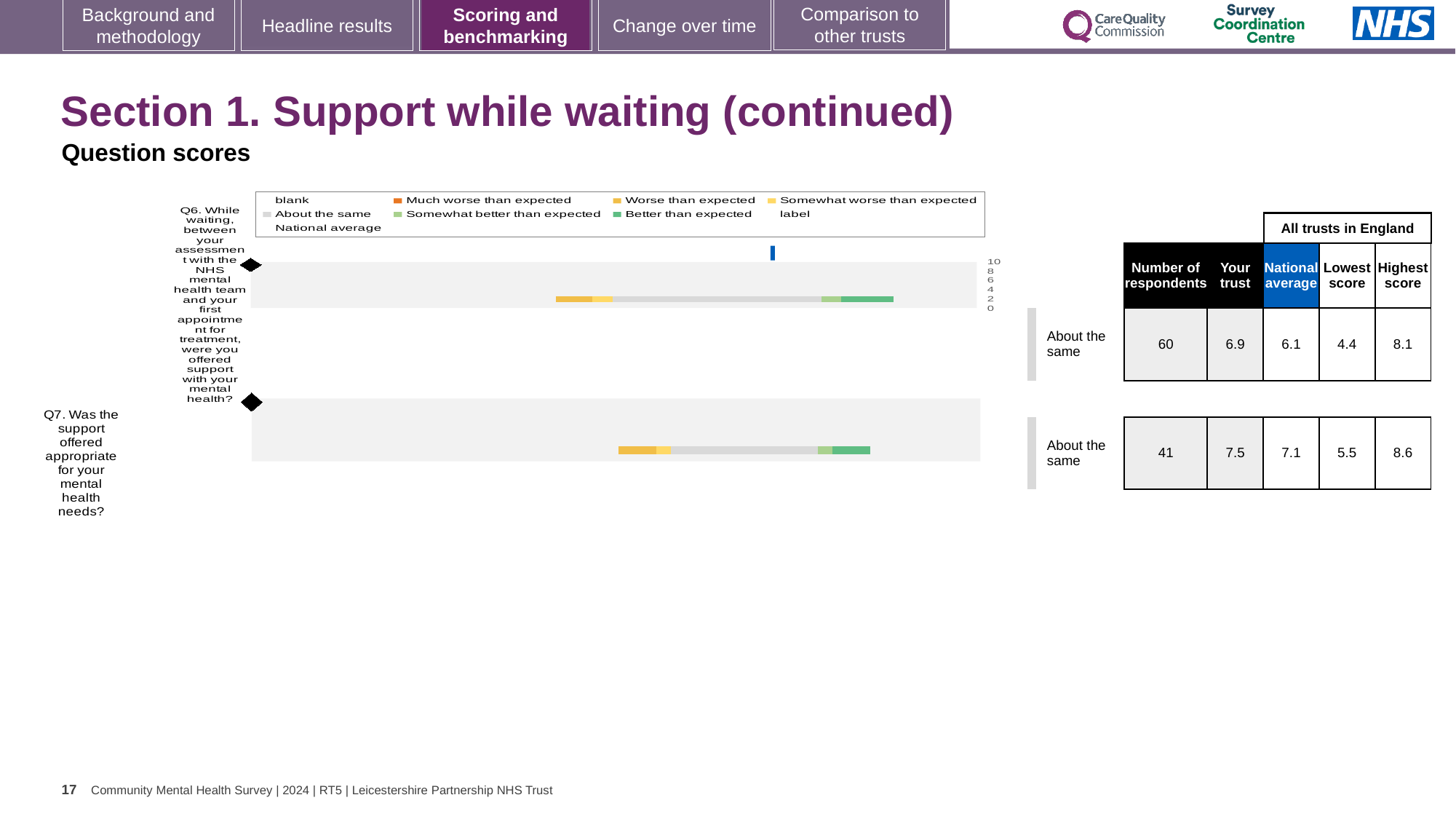
How many questions (categories) are plotted on the chart? 2 What is the 'Your trust' score for Q6 (support while waiting between assessment and first appointment)? 6.9 Which question has the lower number of respondents? Q7 What is the lowest score among all trusts in England for Q6? 4.4 What benchmark rating is shown for both Q6 and Q7? About the same What is the national average score for Q7 (was the support offered appropriate for your mental health needs)? 7.1 What is the highest score among all trusts in England for Q7? 8.6 What kind of chart is used to show the question scores on this slide? bar chart What is the difference between the highest and lowest scores among all trusts in England for Q6? 3.7 How many respondents answered Q6? 60 Which question has the higher 'Your trust' score, Q6 or Q7? Q7 What is the difference between the 'Your trust' score and the national average for Q7? 0.4